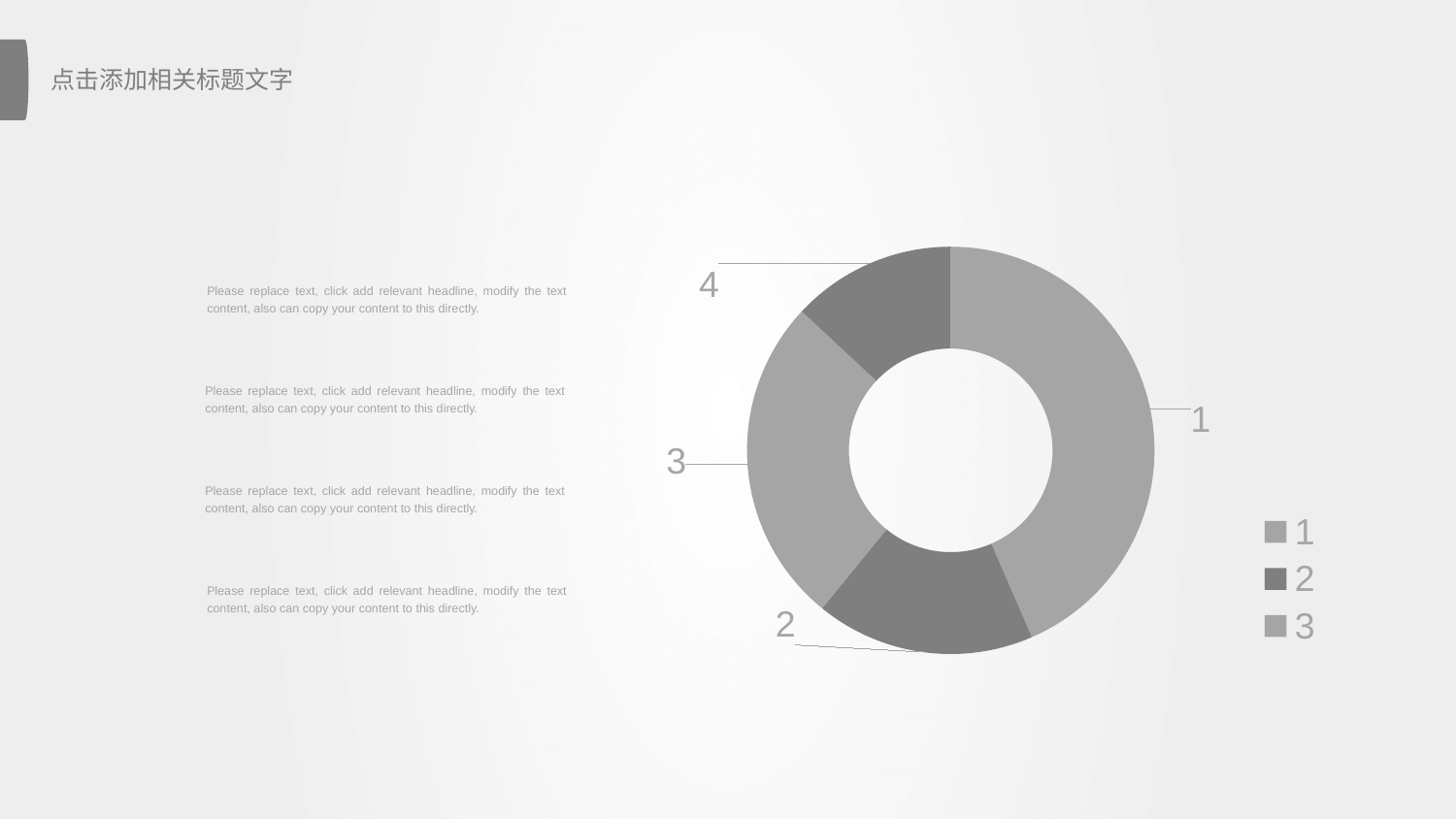
What kind of chart is shown on the slide? Doughnut chart Which slice is larger in the doughnut chart, slice 1 or slice 4? 1 What are the entries listed in the legend of the doughnut chart? 1, 2, 3 Which slice is larger in the doughnut chart, slice 2 or slice 3? 3 Which slice of the doughnut chart is the smallest? 4 Which slice of the doughnut chart is the largest? 1 Which slice is larger in the doughnut chart, slice 1 or slice 3? 1 How many slices does the doughnut chart have? 4 How many entries does the legend of the doughnut chart list? 3 Which slice label of the doughnut chart does not appear in the legend? 4